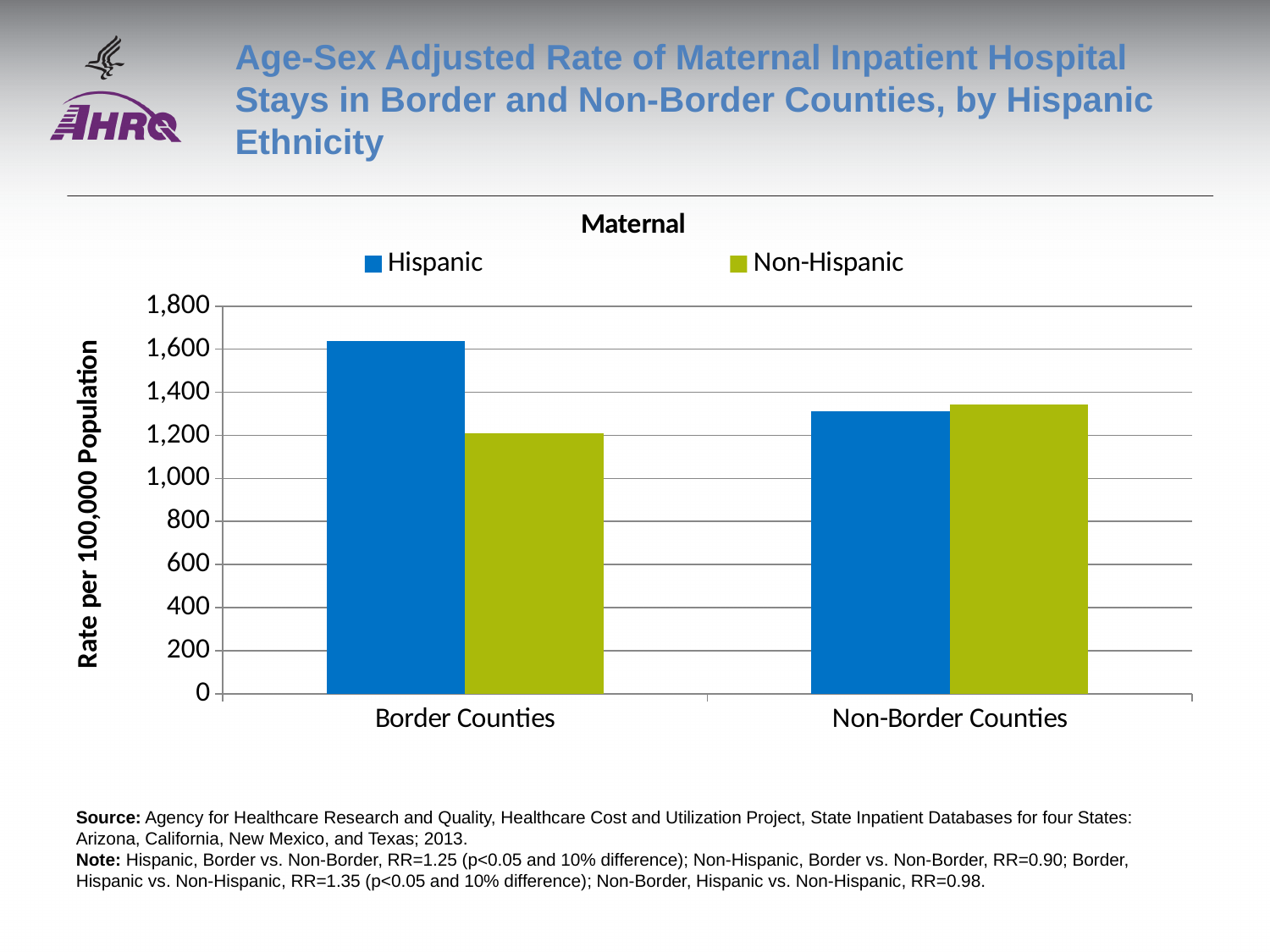
How many county categories are shown on the x axis? 2 Which bar is the lowest in the chart? Non-Hispanic, Border Counties For the Non-Hispanic series, which is larger: Border Counties or Non-Border Counties? Non-Border Counties Is the Non-Hispanic value for Border Counties greater or less than 1,400? less For the Hispanic series, which is larger: Border Counties or Non-Border Counties? Border Counties What is the label of the y axis? Rate per 100,000 Population What kind of chart is shown on the slide? Bar chart Is the Hispanic value for Non-Border Counties greater or less than 1,200? greater Which series has the highest bar in the chart? Hispanic, Border Counties Is the Hispanic value for Border Counties greater or less than 1,600? greater In Border Counties, which is larger: the Hispanic rate or the Non-Hispanic rate? Hispanic How many series does the legend list? 2